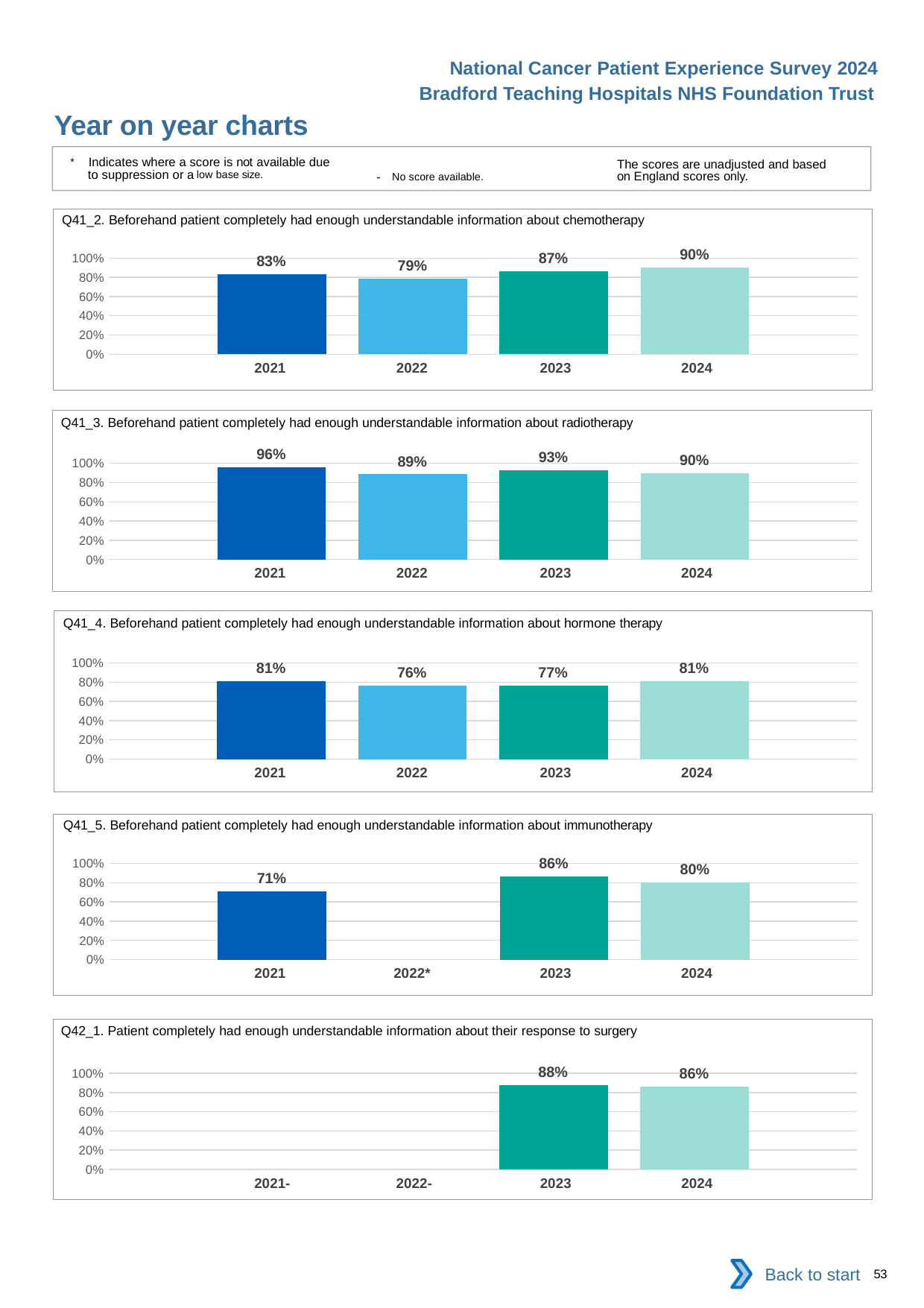
In the Q41_2 chemotherapy chart, which year has the lowest value? 2022 In the Q41_5 immunotherapy chart, what is the value for 2021? 71% In the Q42_1 response to surgery chart, what is the value for 2024? 86% What type of chart is the Q41_2 chemotherapy chart? Bar chart In the Q41_5 immunotherapy chart, which year is marked with an asterisk indicating no score available? 2022 In the Q41_3 radiotherapy chart, which year has the highest value? 2021 In the Q41_4 hormone therapy chart, is the value for 2023 larger or smaller than the value for 2024? smaller In the Q41_5 immunotherapy chart, how many years have a bar plotted? 3 In the Q42_1 response to surgery chart, what is the difference between the 2023 and 2024 values? 2 percentage points In the Q41_4 hormone therapy chart, what is the value for 2022? 76% In the Q41_2 chemotherapy chart, what is the value for 2023? 87% In the Q41_3 radiotherapy chart, what is the difference between the 2021 and 2022 values? 7 percentage points